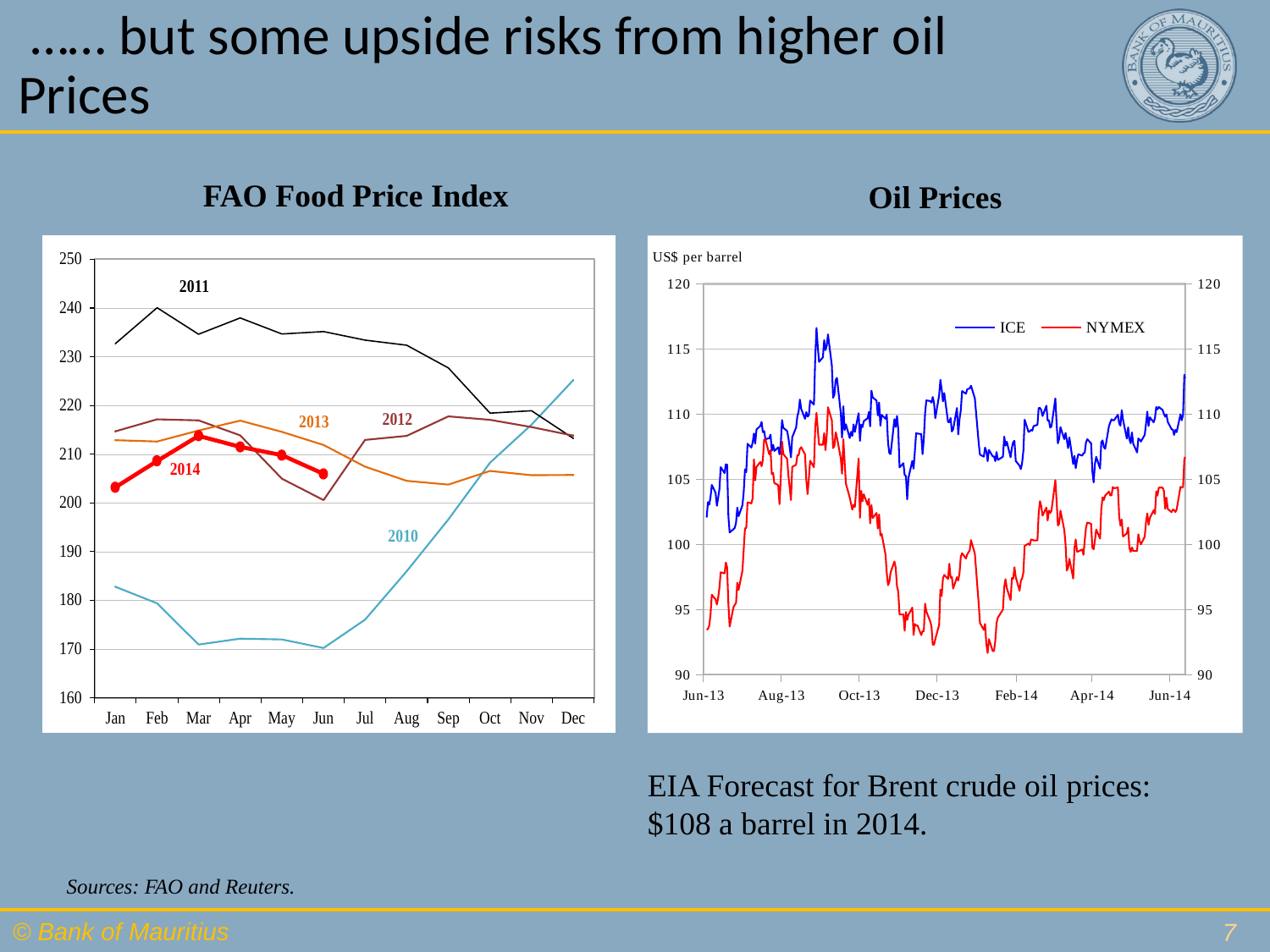
How many months are shown on the x axis of the FAO Food Price Index chart? 12 How many series does the legend of the Oil Prices chart list? 2 What kind of chart is the FAO Food Price Index chart? line chart In the Oil Prices chart, which series is higher at Jun-14, ICE or NYMEX? ICE In the FAO Food Price Index chart, which year's line is highest in January? 2011 In the FAO Food Price Index chart, does the 2010 line rise or fall from July to December? rise In the FAO Food Price Index chart, which year's line is lowest in January? 2010 In the FAO Food Price Index chart, is the value for 2010 in June greater or less than 180? less What kind of chart is the Oil Prices chart? line chart In the FAO Food Price Index chart, is the value for 2011 in February greater or less than 230? greater In the Oil Prices chart, is the NYMEX value at Jun-13 greater or less than 95? less What unit is shown on the Oil Prices chart? US$ per barrel